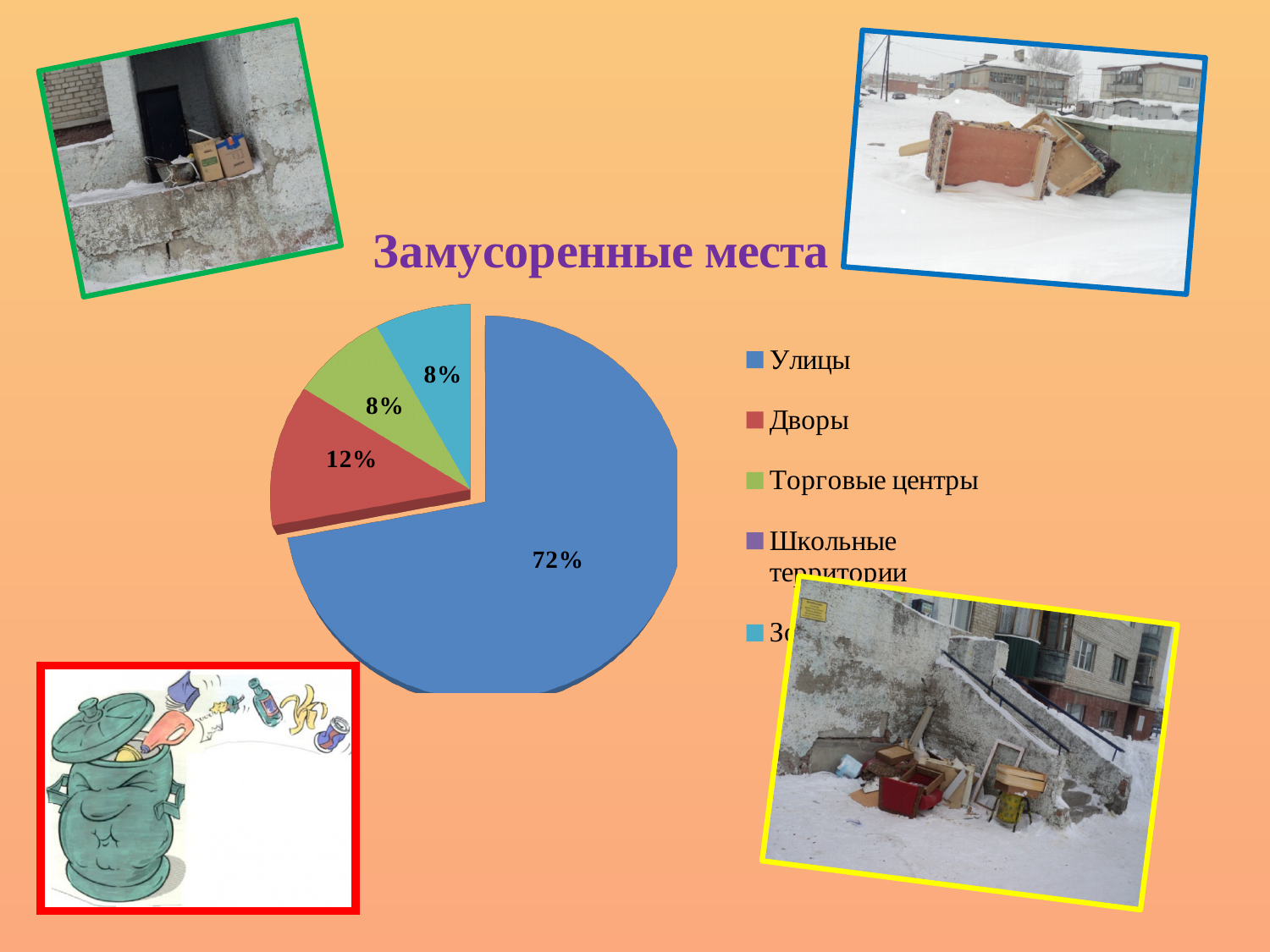
What value is shown for the Дворы slice of the pie chart? 12% What is the title of the chart on the slide? Замусоренные места What type of chart is shown on the slide? pie chart How many data labels are printed on the pie chart? 4 What is the difference in percentage points between the Улицы slice and the Дворы slice? 60% How many entries does the chart legend list? 5 How many percentage points larger is the Дворы slice than the Торговые центры slice? 4% What value is shown for the Торговые центры slice? 8% Which is larger, the slice for Улицы or the slice for Дворы? Улицы What colour is the Улицы slice in the pie chart? blue Which category has the largest slice in the pie chart? Улицы What percentage of the pie chart is labelled for Улицы? 72%